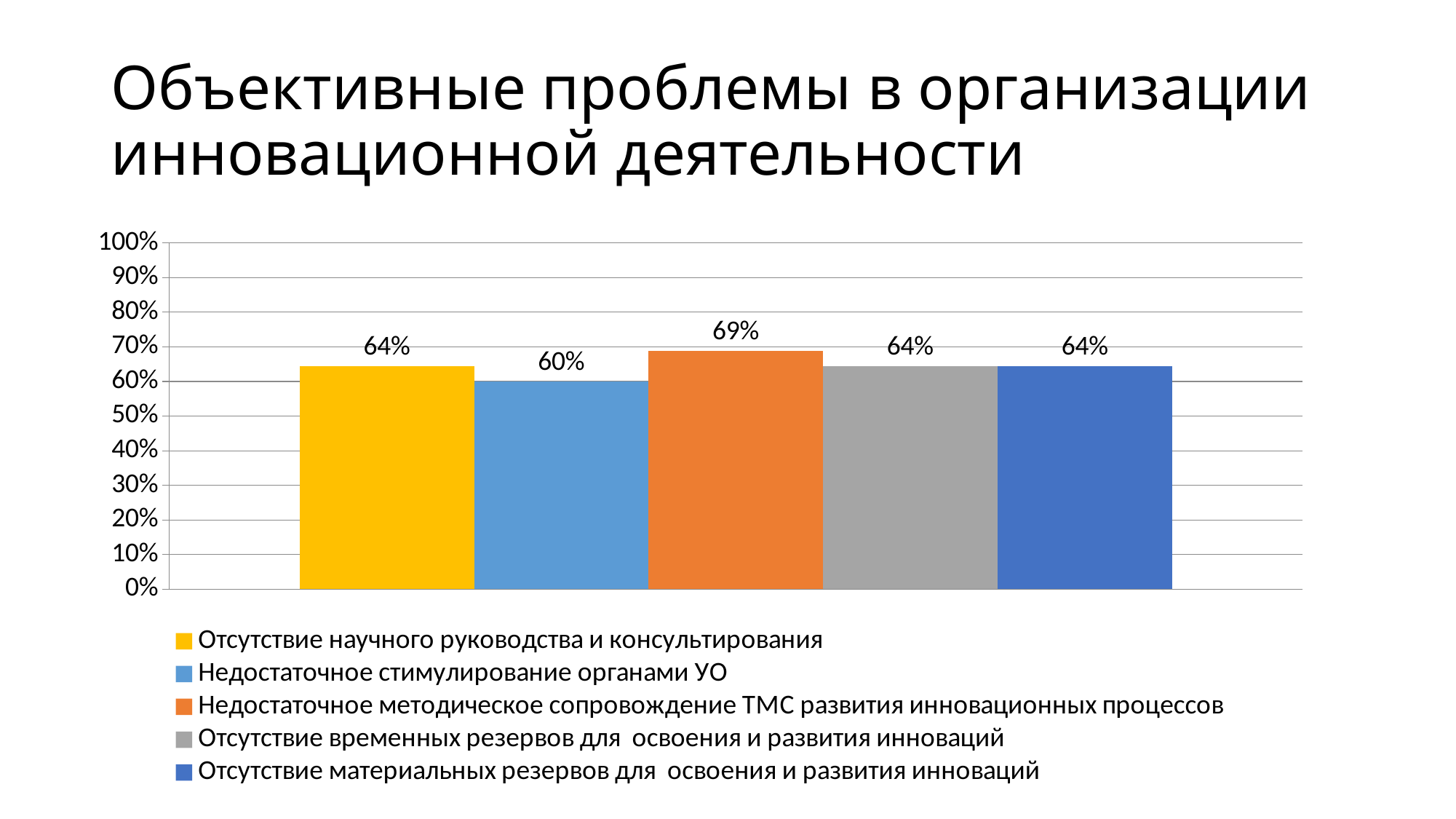
What value is shown for "Отсутствие научного руководства и консультирования"? 64% What value is shown for "Недостаточное стимулирование органами УО"? 60% What value is shown for "Отсутствие материальных резервов для освоения и развития инноваций"? 64% Is the value for "Отсутствие временных резервов для освоения и развития инноваций" greater or less than 50%? greater Which problem has the lowest value on the chart? Недостаточное стимулирование органами УО What value is shown for "Недостаточное методическое сопровождение ТМС развития инновационных процессов"? 69% How many bars are plotted on the chart? 5 What type of chart is shown on the slide? bar chart Which problem has the highest value on the chart? Недостаточное методическое сопровождение ТМС развития инновационных процессов What is the difference between the highest value (69%) and the lowest value (60%) on the chart? 9% Which is larger: the value for "Недостаточное методическое сопровождение ТМС развития инновационных процессов" or the value for "Недостаточное стимулирование органами УО"? Недостаточное методическое сопровождение ТМС развития инновационных процессов How many entries does the legend list? 5